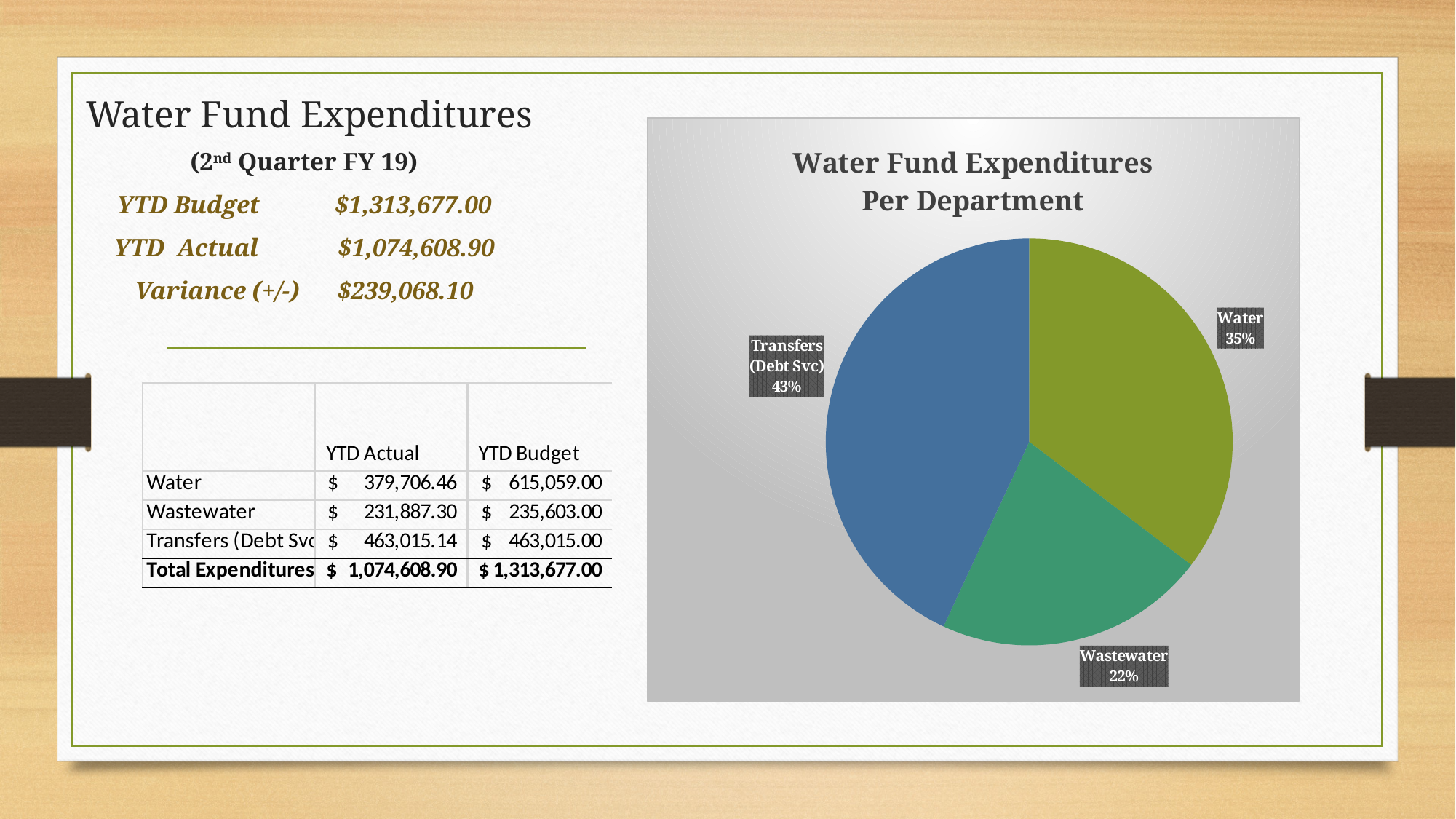
What share of the pie does Water represent? 35% What share of the pie does Wastewater represent? 22% What colour is the Wastewater slice? green How many slices does the pie chart have? 3 What type of chart is shown on the slide? pie chart What share of the pie does Transfers (Debt Svc) represent? 43% Which department has the smallest slice of the pie? Wastewater Which department has the largest slice of the pie? Transfers (Debt Svc) What is the difference in percentage points between the Transfers (Debt Svc) slice and the Water slice? 8 Which slice is larger, Water or Wastewater? Water What is the title of the chart? Water Fund Expenditures Per Department What is the difference in percentage points between the Water slice and the Wastewater slice? 13